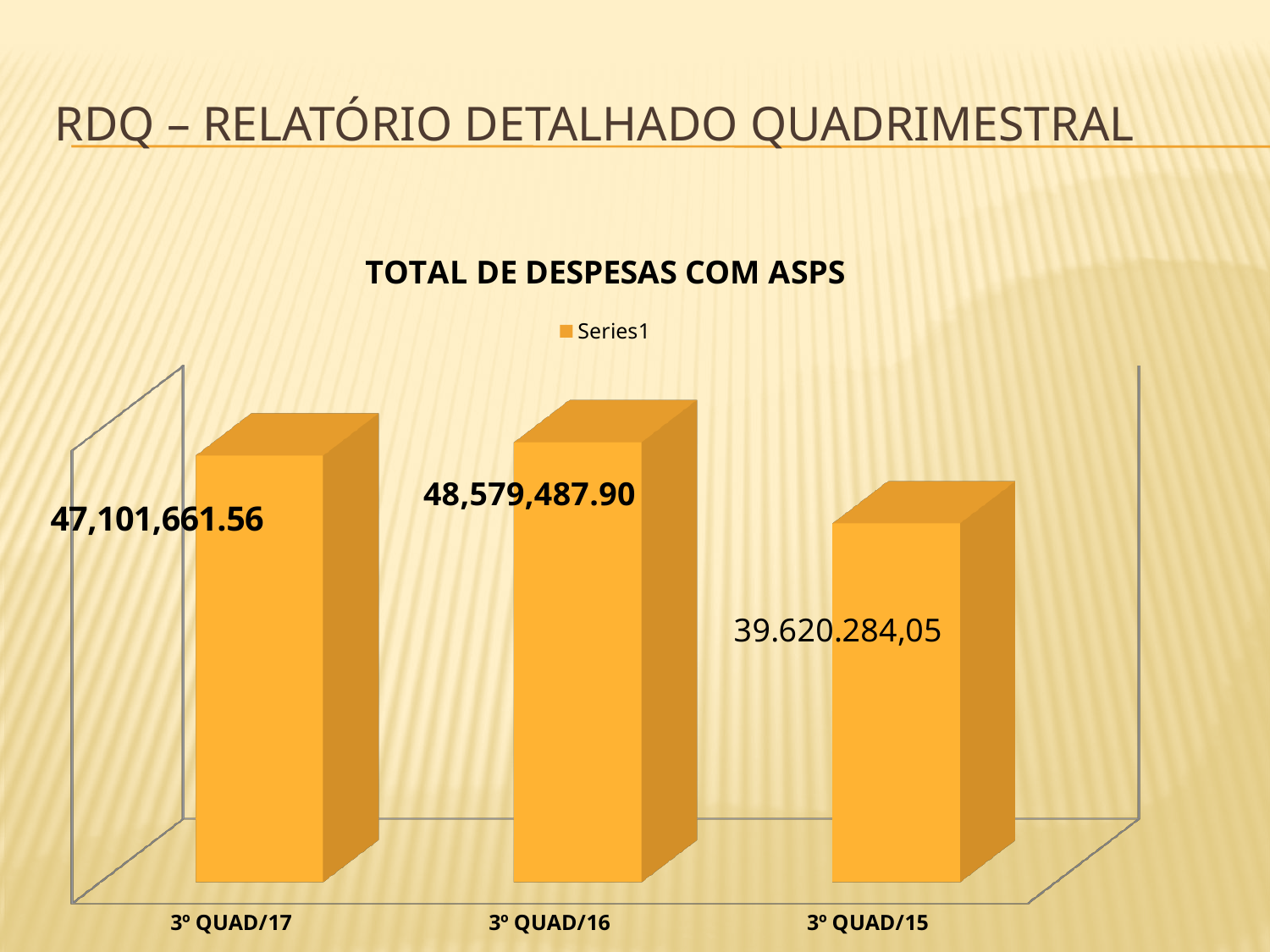
What kind of chart is shown on the slide? Bar chart Which category has the highest value in the chart? 3º QUAD/16 How many series does the legend list? 1 What is the value for 3º QUAD/16 in the chart? 48,579,487.90 How many categories are shown on the x axis of the chart? 3 What is the title of the chart? TOTAL DE DESPESAS COM ASPS Which category has the lowest value in the chart? 3º QUAD/15 Does the value rise or fall from 3º QUAD/16 to 3º QUAD/15? Fall What is the value for 3º QUAD/15 in the chart? 39.620.284,05 What is the value for 3º QUAD/17 in the chart? 47,101,661.56 What is the difference between the values for 3º QUAD/16 and 3º QUAD/17? 1,477,826.34 Which is larger, the value for 3º QUAD/17 or the value for 3º QUAD/15? 3º QUAD/17